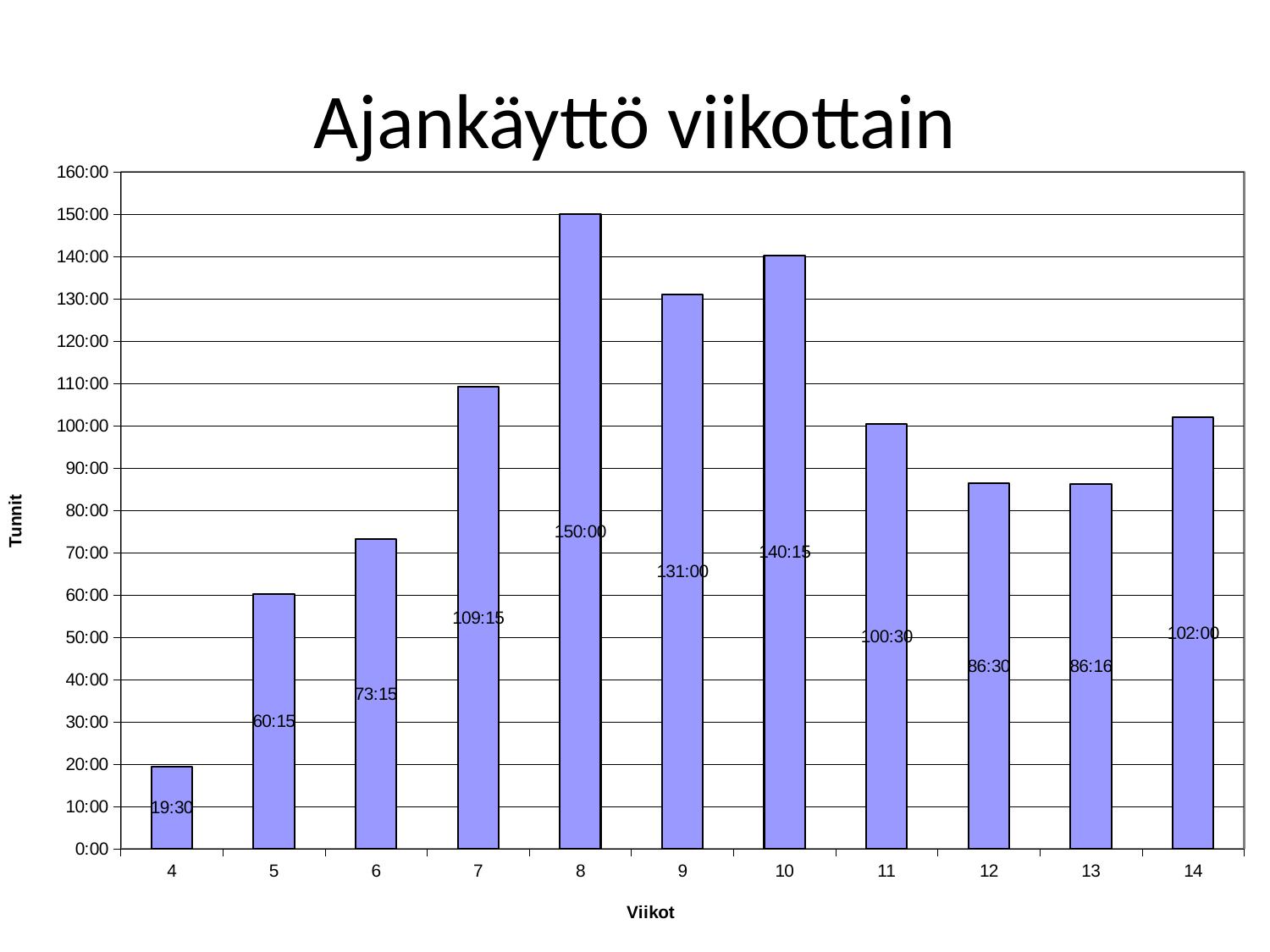
Which week has the highest value? 8 What is the value for week 13? 86:16 How many weeks are shown on the x axis? 11 What kind of chart is shown on the slide? bar chart What is the value for week 8? 150:00 Which week has the lowest value? 4 Which is larger, the value for week 10 or the value for week 9? week 10 Is the value for week 7 greater or less than 100:00? greater What is the difference between the values for week 14 and week 11? 1:30 What is the difference between the values for week 8 and week 9? 19:00 What is the title of the chart? Ajankäyttö viikottain What is the value for week 4? 19:30